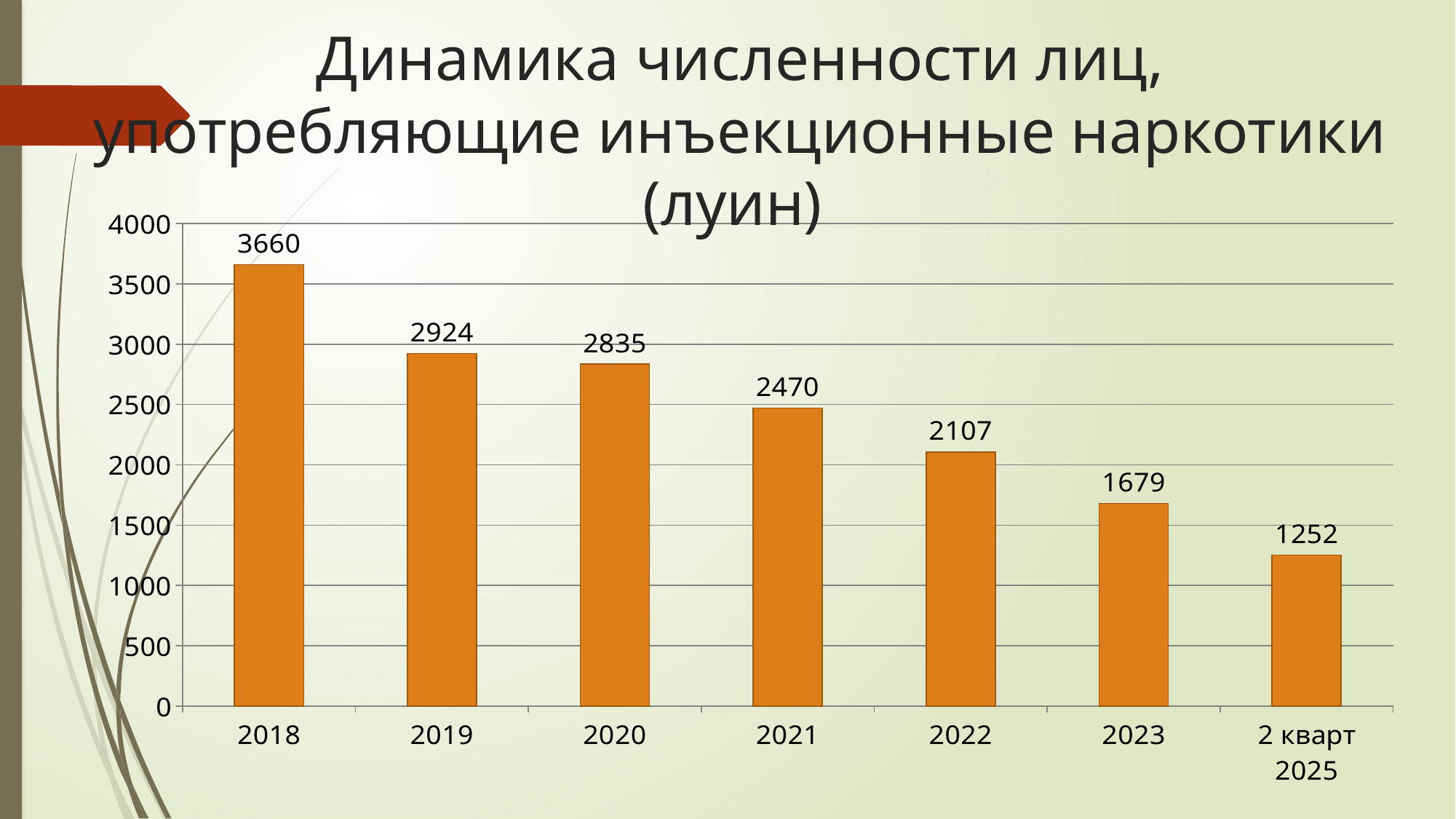
How many categories are shown on the x axis? 7 What is the difference between the values for 2018 and 2019? 736 Which category has the lowest value? 2 кварт 2025 What is the difference between the values for 2022 and 2023? 428 Which category has the highest value? 2018 Is the value for 2023 greater or less than 2000? less What kind of chart is shown on the slide? bar chart Do the values rise or fall from 2018 to 2 кварт 2025? fall What is the value for 2 кварт 2025? 1252 What is the value for 2021? 2470 What is the value for 2018? 3660 Which is larger, the value for 2020 or the value for 2021? 2020